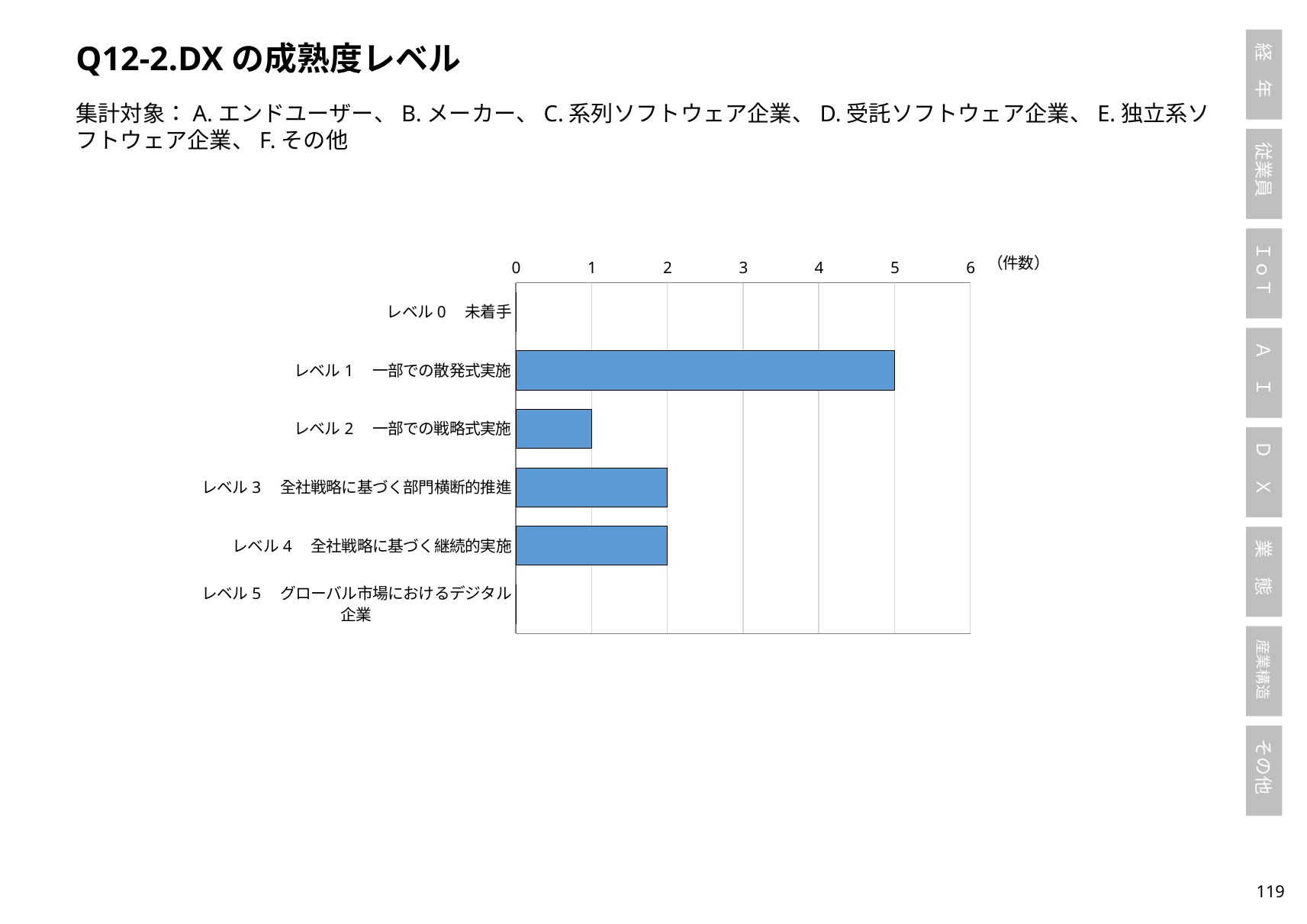
What is the value for レベル 1 一部での散発式実施? 5 What unit label is shown next to the horizontal axis? （件数） What is the value for レベル 4 全社戦略に基づく継続的実施? 2 Which is larger, the value for レベル 1 or the value for レベル 3? レベル 1 What is the value for レベル 2 一部での戦略式実施? 1 Is the value for レベル 1 greater or less than 4? greater What is the difference between the values for レベル 1 and レベル 2? 4 What kind of chart is shown on the slide? bar chart What is the value for レベル 3 全社戦略に基づく部門横断的推進? 2 What is the title of the slide containing the chart? Q12-2.DX の成熟度レベル Which level has the highest value? レベル 1 一部での散発式実施 How many categories (levels) are plotted on the chart? 6